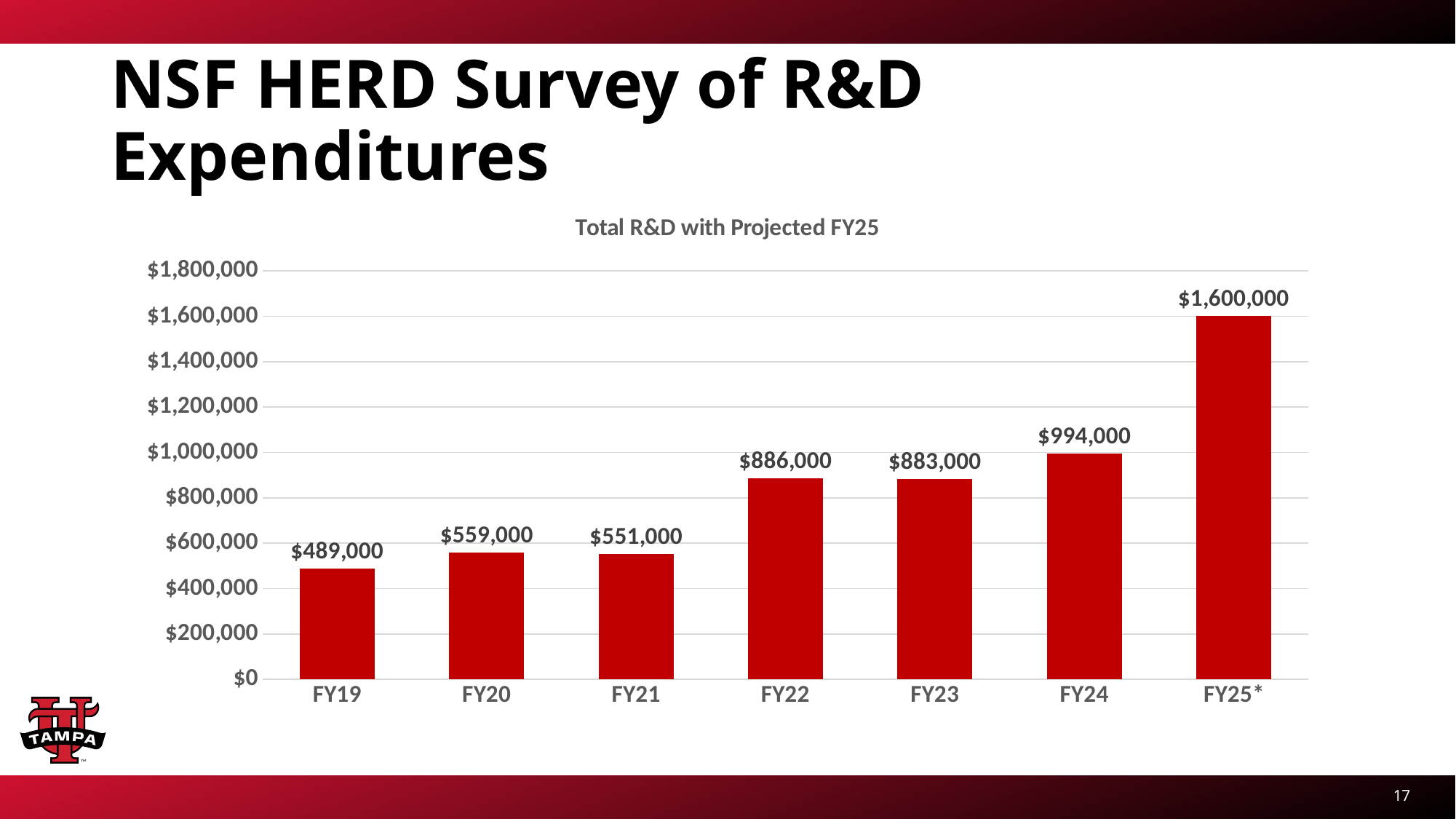
What is the projected value for FY25*? $1,600,000 Which fiscal year has the highest value? FY25* What kind of chart is shown? bar chart Is the value for FY24 greater or less than $1,000,000? less What is the value for FY22? $886,000 Which fiscal year has the lowest value? FY19 What is the difference between the FY25* and FY24 values? $606,000 How many fiscal years are shown on the x axis? 7 What is the title of the chart? Total R&D with Projected FY25 What is the difference between the FY24 and FY23 values? $111,000 Which is larger, the value for FY20 or the value for FY21? FY20 What is the value for FY19? $489,000